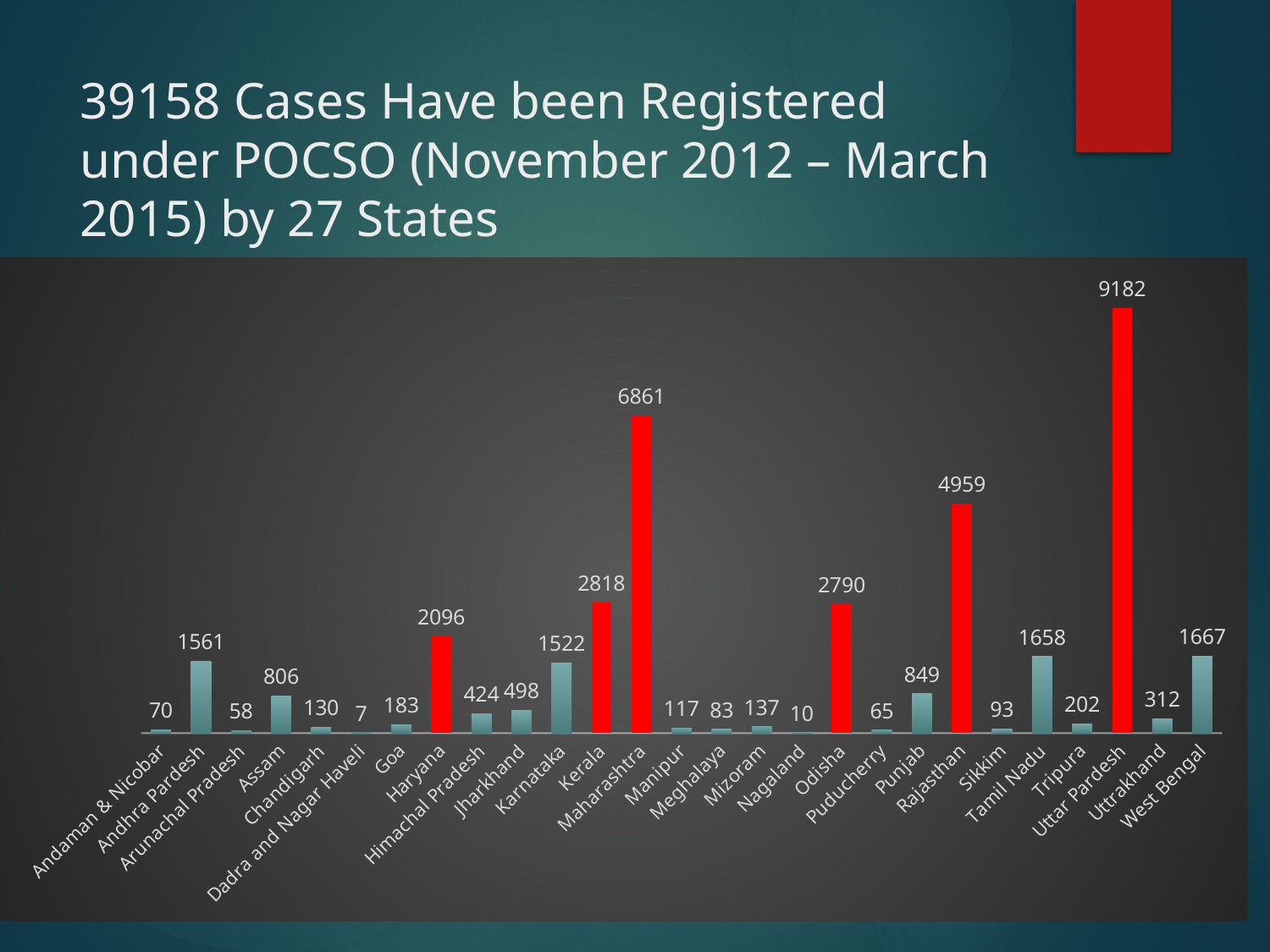
What is the value shown for Nagaland? 10 What is the value shown for Punjab? 849 How many cases were registered in Maharashtra according to the chart? 6861 How many states or territories are shown on the x axis of the chart? 27 Which has a larger value, Kerala or Odisha? Kerala Which category has the lowest value in the chart? Dadra and Nagar Haveli What is the difference between the values for West Bengal and Tamil Nadu? 9 What is the difference between the values for Uttar Pardesh and Maharashtra? 2321 Which state has the highest number of registered cases in the chart? Uttar Pardesh What type of chart is shown on the slide? Bar chart How many bars in the chart are coloured red? 6 What is the value shown for Rajasthan? 4959